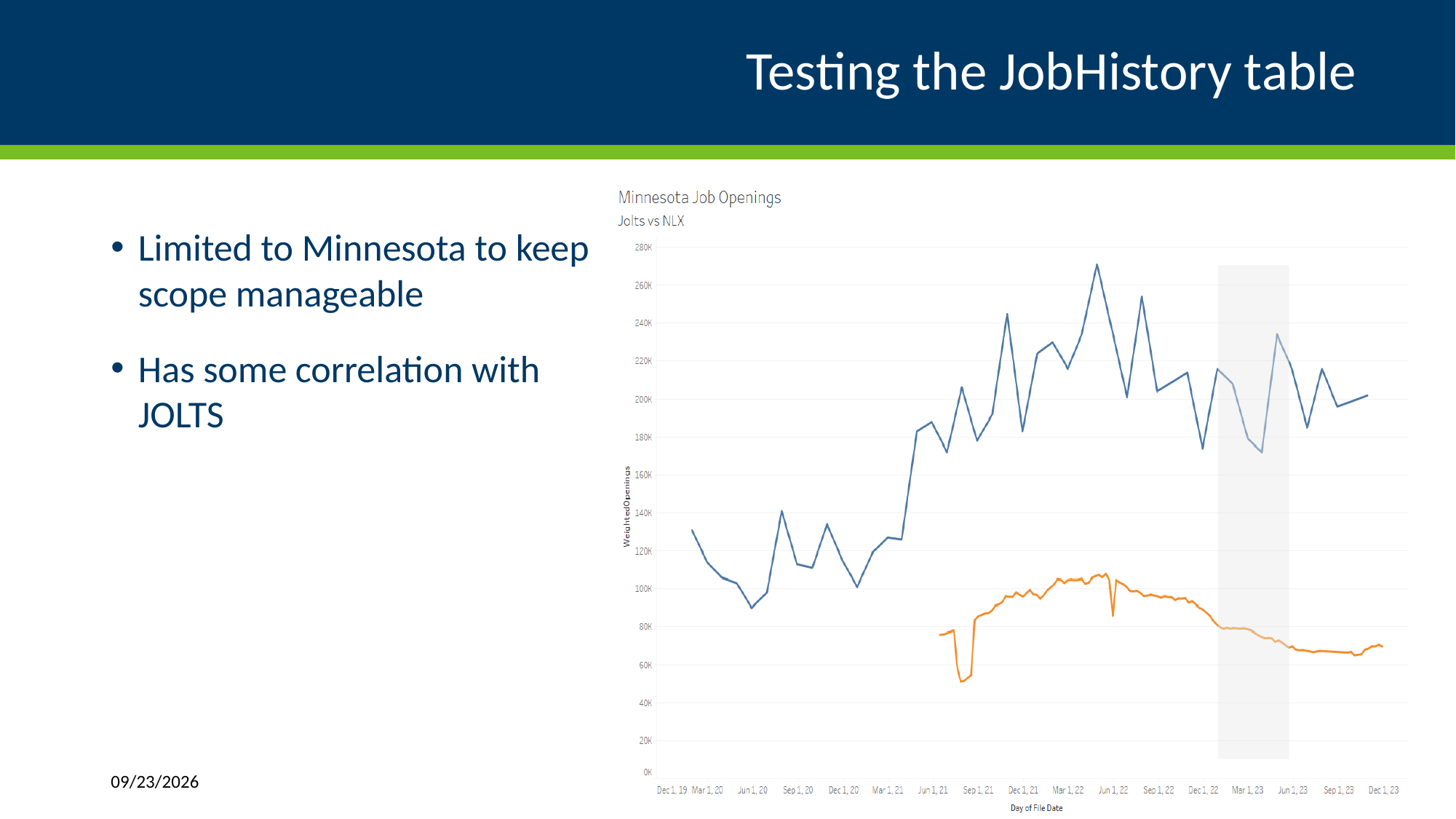
Is the highest point of the blue line greater or less than 260K? greater What kind of chart is shown on the slide? line chart Does the orange line generally rise or fall between Jun 1, 22 and Dec 1, 23? fall Is the value of the orange line at Dec 1, 23 greater or less than 80K? less Is the lowest point of the orange line greater or less than 60K? less At Mar 1, 22, which line has the higher value, the blue line or the orange line? the blue line How many lines are plotted on the chart? 2 What is the title of the chart? Minnesota Job Openings Does the blue line generally rise or fall between Dec 1, 20 and Jun 1, 22? rise What is the label on the vertical axis of the chart? WeightedOpenings